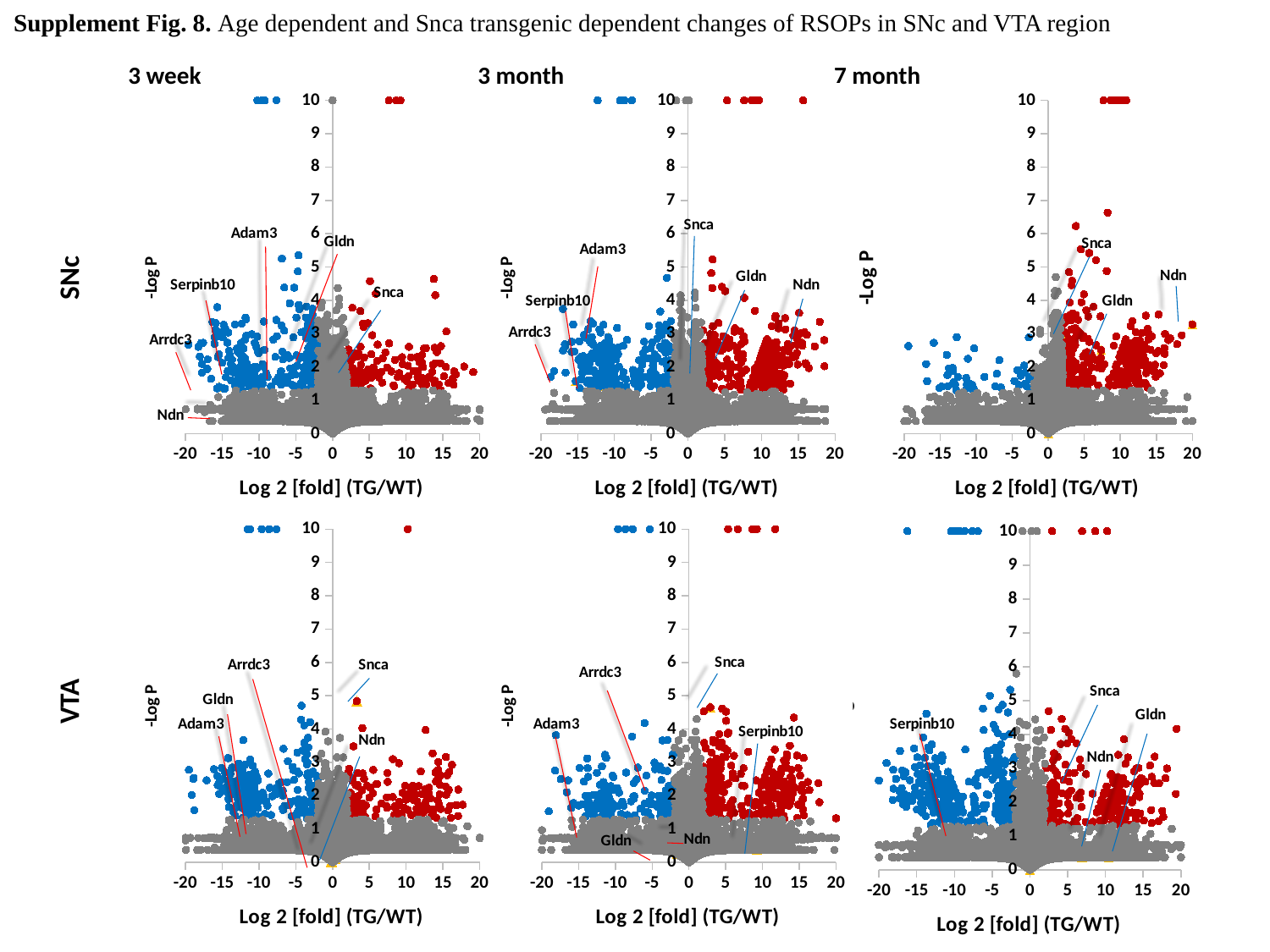
In the VTA 3 week chart, which has the higher -Log P value, Snca or Ndn? Snca How many gene labels are annotated on the SNc 3 week chart? 6 What is the x-axis label on the SNc 3 week chart? Log 2 [fold] (TG/WT) How many charts are shown on the slide? 6 What is the minimum value shown on the x axis of the VTA 3 week chart? -20 What is the maximum value shown on the y axis of the SNc 3 month chart? 10 How many gene labels are annotated on the SNc 7 month chart? 3 In the VTA 3 week chart, is the -Log P value for Snca greater or less than 4? greater In the VTA 3 month chart, is the -Log P value for Gldn greater or less than 1? less What is the y-axis label on the VTA 7 month chart? -Log P What kind of chart is used in each of the six panels on the slide? Scatter chart In the SNc 3 week chart, is the -Log P value for Ndn greater or less than 1? less